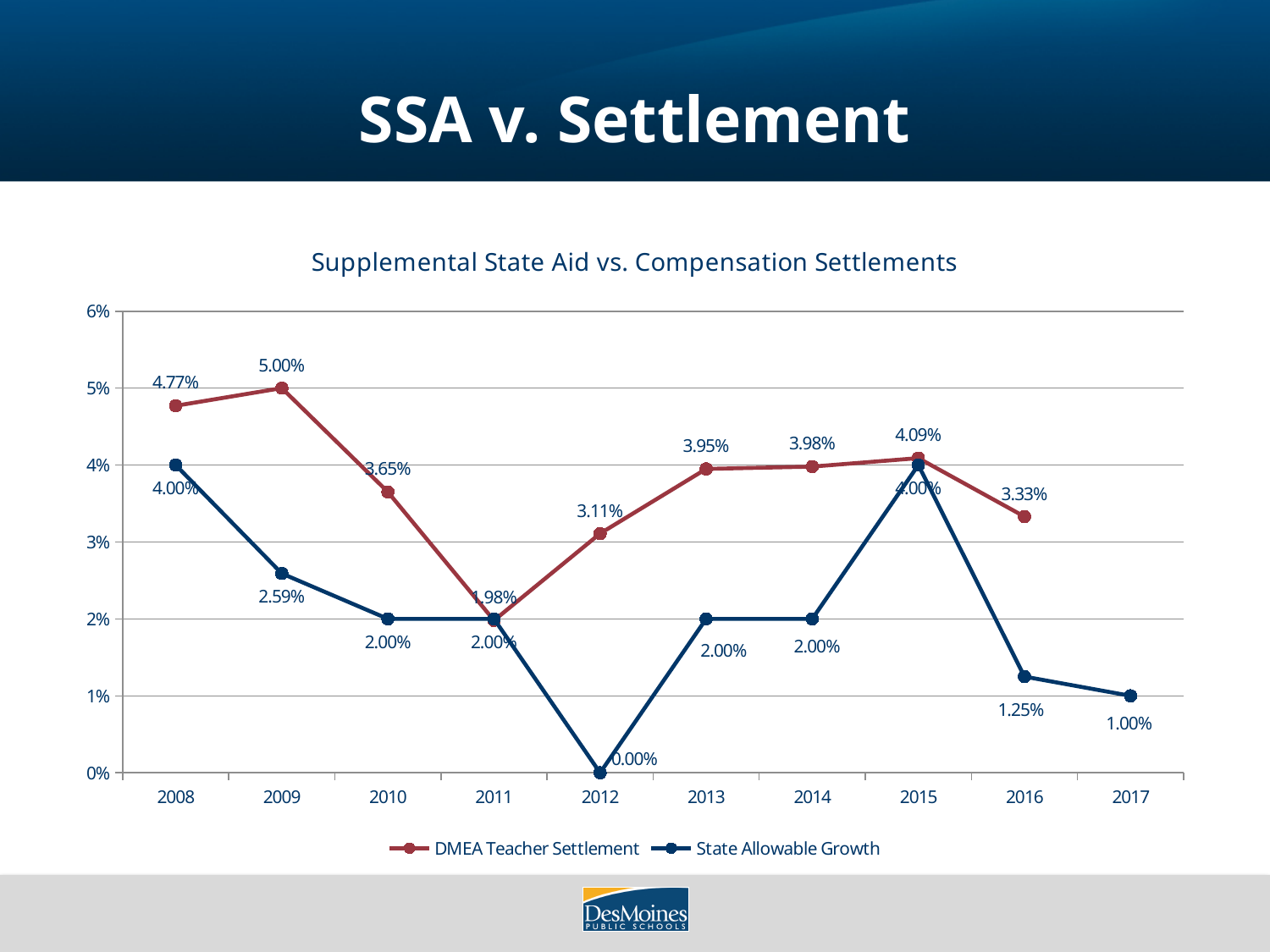
Which is larger in 2010, the DMEA Teacher Settlement or the State Allowable Growth? DMEA Teacher Settlement What is the difference between the DMEA Teacher Settlement and State Allowable Growth in 2012? 3.11% What is the DMEA Teacher Settlement value for 2009? 5.00% What is the title of the chart? Supplemental State Aid vs. Compensation Settlements How many years are shown on the x axis? 10 In which year is the State Allowable Growth lowest? 2012 How many series does the legend list? 2 What type of chart is shown on the slide? Line chart In which year is the DMEA Teacher Settlement highest? 2009 What is the State Allowable Growth value for 2016? 1.25% What is the DMEA Teacher Settlement value for 2015? 4.09% Does the State Allowable Growth rise or fall from 2015 to 2017? Fall